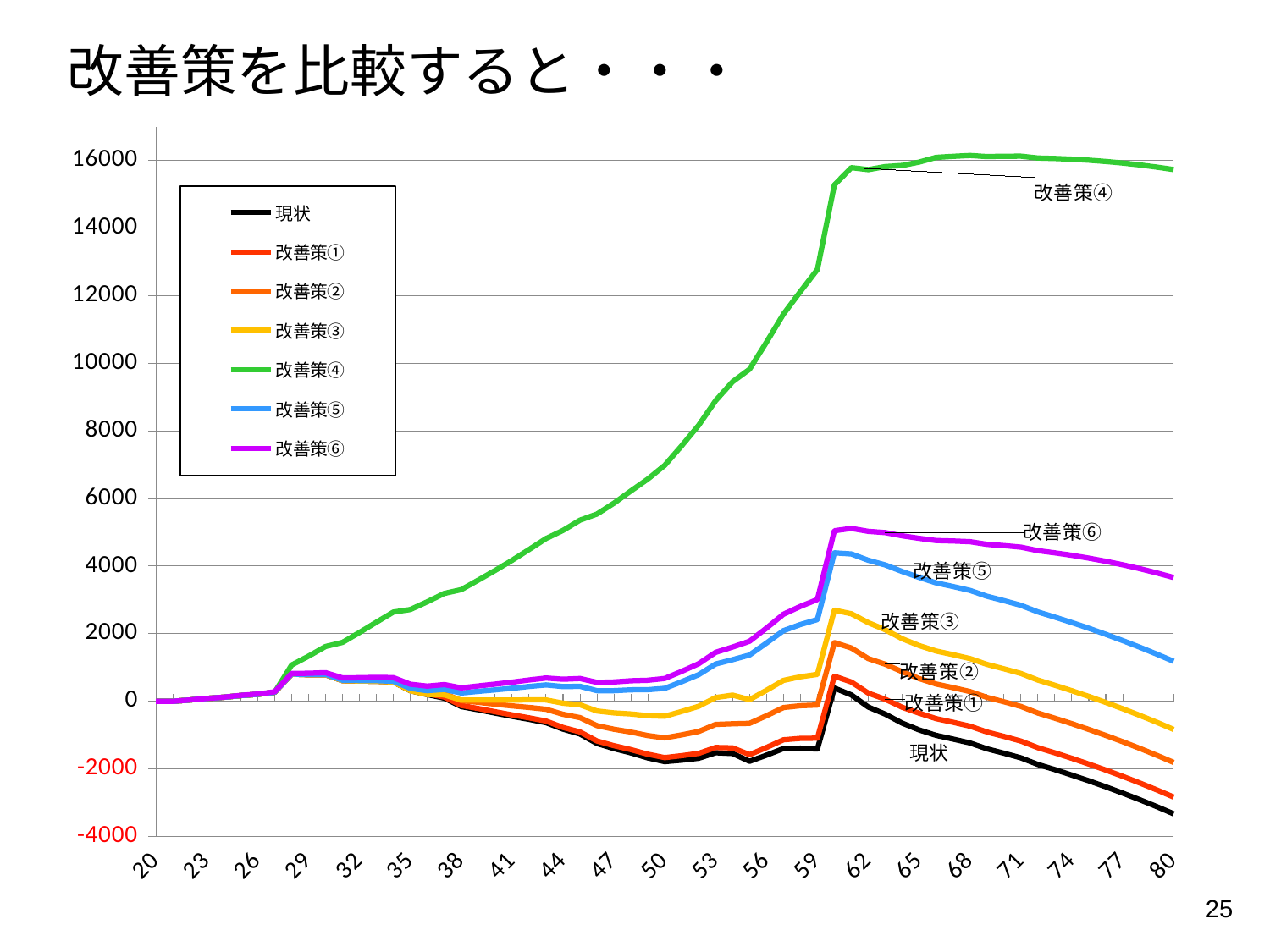
Which series has the lowest value at age 80? 現状 Does the 改善策④ line rise or fall from age 20 to age 62? rise Is the value for 改善策⑥ at age 62 greater or less than 4000? greater Is the value for 改善策③ at age 80 greater or less than 0? less Is the value for 現状 at age 80 greater or less than -2000? less How many series does the legend list? 7 What kind of chart is shown on the slide? line chart Which series has the highest value at age 80? 改善策④ At age 80, which is larger, 改善策⑤ or 改善策⑥? 改善策⑥ Does the 現状 line rise or fall from age 62 to age 80? fall What colour is the 改善策④ line in the legend? green